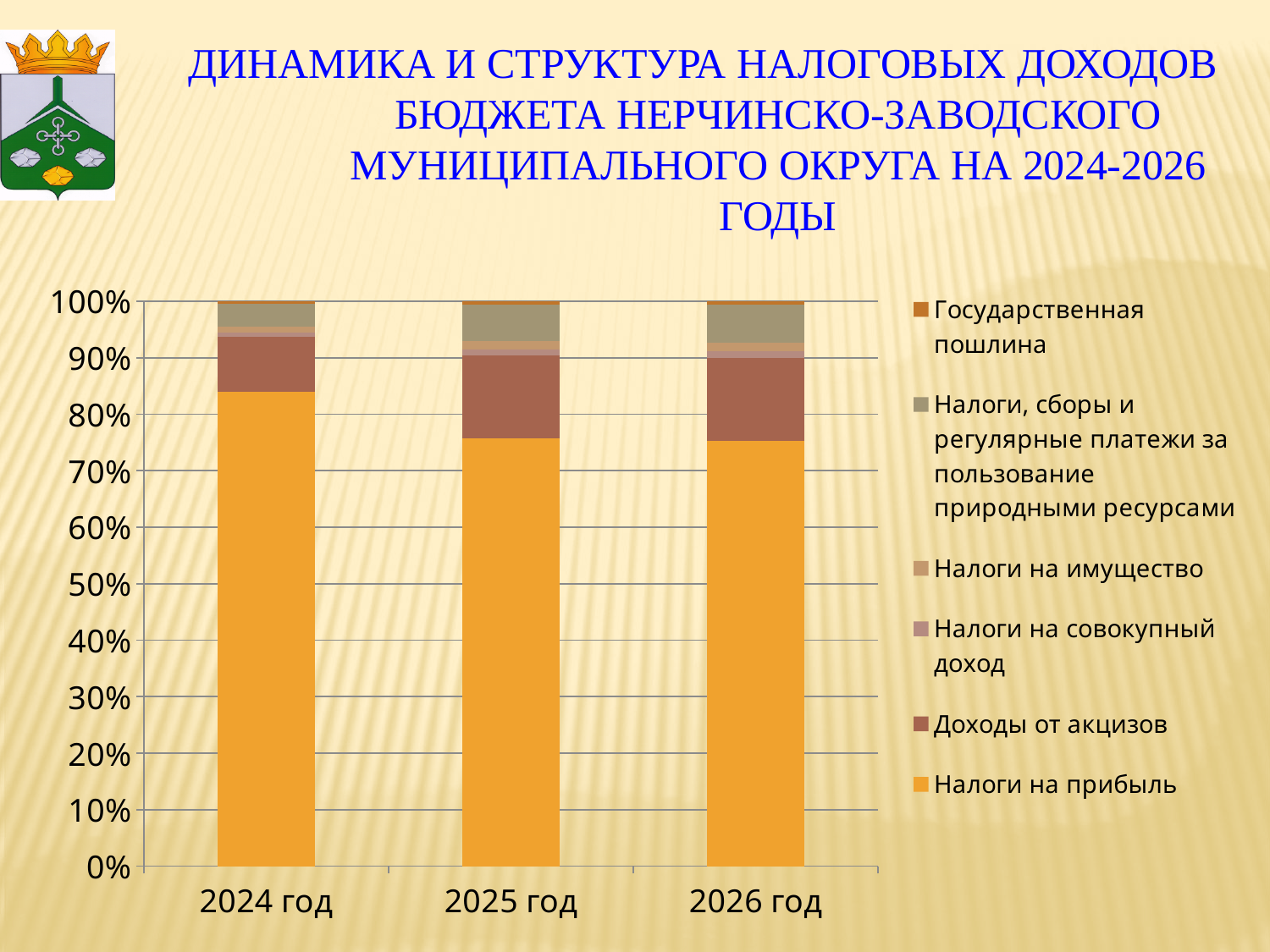
Does the share of Налоги на прибыль rise or fall from 2024 год to 2026 год? fall Which year has the larger share of Доходы от акцизов: 2024 год or 2025 год? 2025 год Is the share of Налоги на прибыль in 2025 год greater or less than 80%? less What kind of chart is shown on the slide? Stacked bar chart In which year is the share of Налоги на прибыль the highest? 2024 год Which series is shown at the bottom of each stacked bar? Налоги на прибыль Is the share of Налоги на прибыль in 2024 год greater or less than 80%? greater Is the share of Налоги на прибыль in 2026 год greater or less than 80%? less How many series does the chart legend list? 6 Which year has the larger share of Налоги на прибыль: 2024 год or 2025 год? 2024 год How many years (categories) are shown on the x axis of the chart? 3